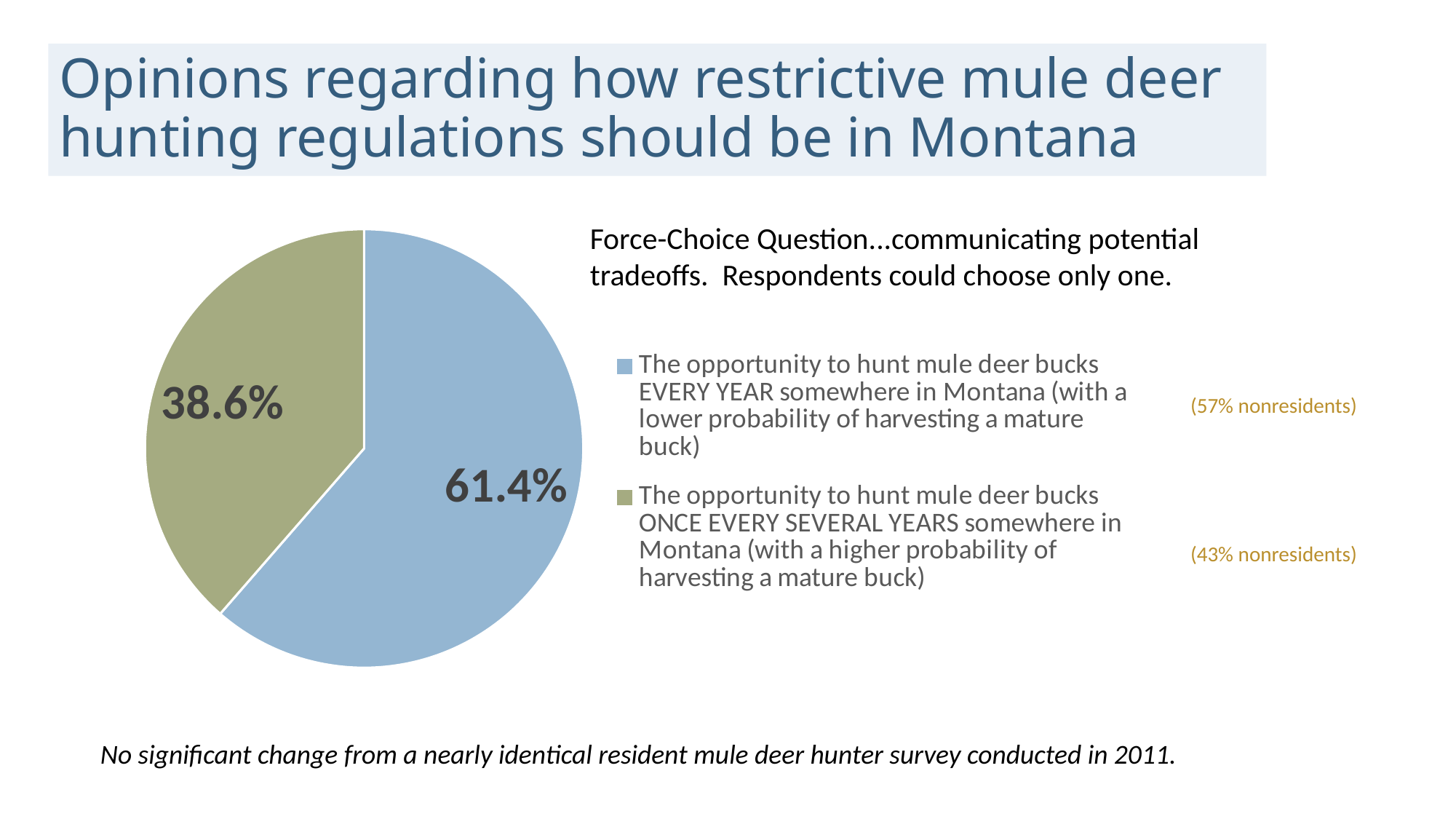
How many slices does the pie chart have? 2 How many entries does the legend list? 2 What percentage of respondents chose the opportunity to hunt mule deer bucks ONCE EVERY SEVERAL YEARS somewhere in Montana? 38.6% Which is larger: the share for hunting EVERY YEAR or the share for hunting ONCE EVERY SEVERAL YEARS? EVERY YEAR What is the difference in percentage points between the EVERY YEAR option and the ONCE EVERY SEVERAL YEARS option? 22.8 What percentage of respondents chose the opportunity to hunt mule deer bucks EVERY YEAR somewhere in Montana? 61.4% Which option received the smallest share of respondents? The opportunity to hunt mule deer bucks ONCE EVERY SEVERAL YEARS somewhere in Montana What percentage of nonresidents chose the EVERY YEAR option, according to the note beside the legend? 57% What colour is the slice representing the EVERY YEAR option? blue What kind of chart is shown on the slide? pie chart What colour is the slice representing the ONCE EVERY SEVERAL YEARS option? olive green Which option received the largest share of respondents? The opportunity to hunt mule deer bucks EVERY YEAR somewhere in Montana